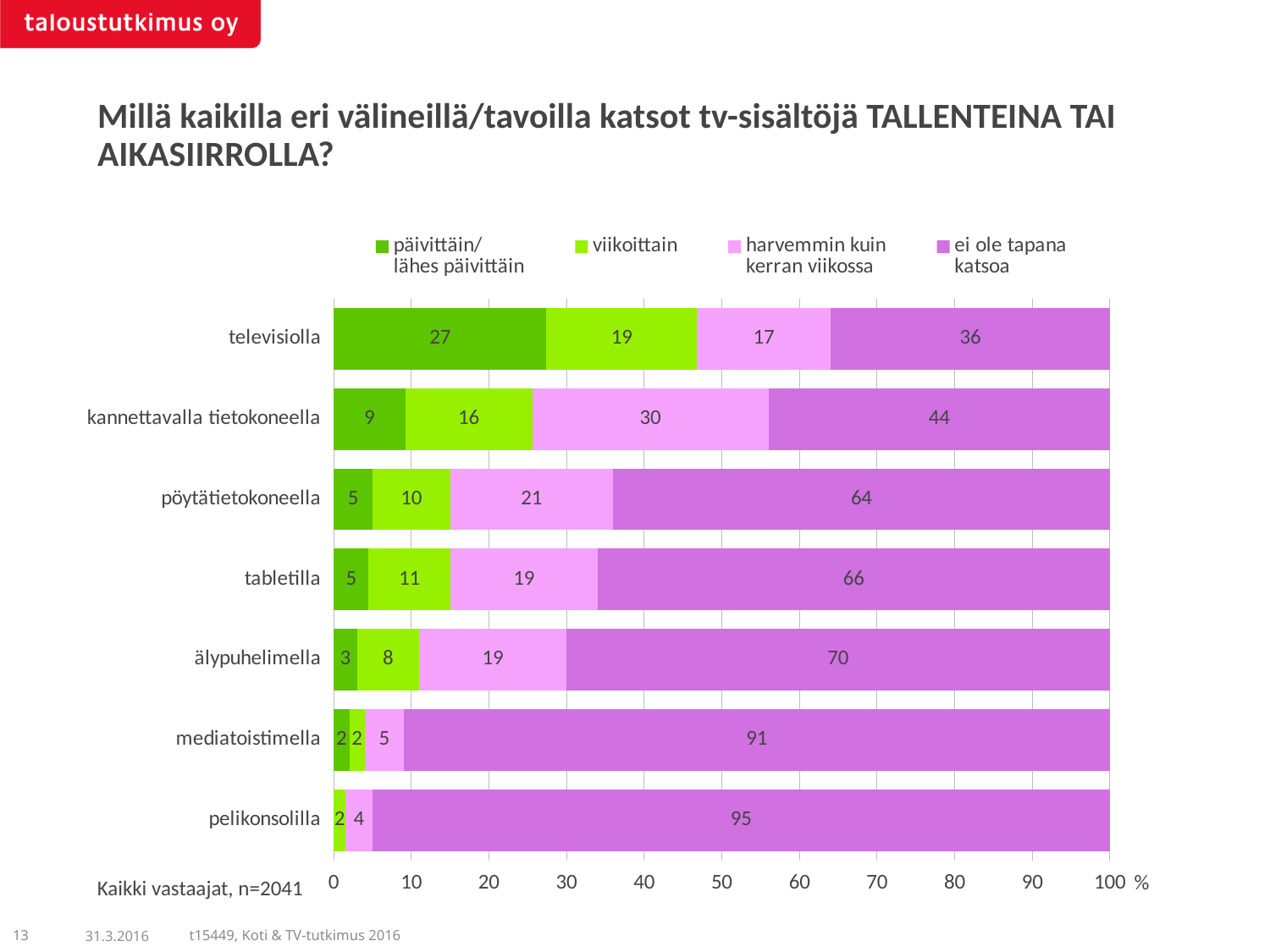
How many categories are shown on the y axis of the chart? 7 How many series does the legend list? 4 What is the difference between the "päivittäin/lähes päivittäin" values for televisiolla and kannettavalla tietokoneella? 18 What is the total of the four labelled segments in the televisiolla bar? 99 Which category has the highest value for "päivittäin/lähes päivittäin"? televisiolla Which category has the highest value for "ei ole tapana katsoa"? pelikonsolilla What is the value for "harvemmin kuin kerran viikossa" for kannettavalla tietokoneella? 30 Which has a larger "ei ole tapana katsoa" value, tabletilla or pöytätietokoneella? tabletilla What is the value for "viikoittain" for älypuhelimella? 8 What kind of chart is shown on the slide? stacked bar chart What is the value for "ei ole tapana katsoa" for televisiolla? 36 What colour represents "ei ole tapana katsoa" in the legend? purple